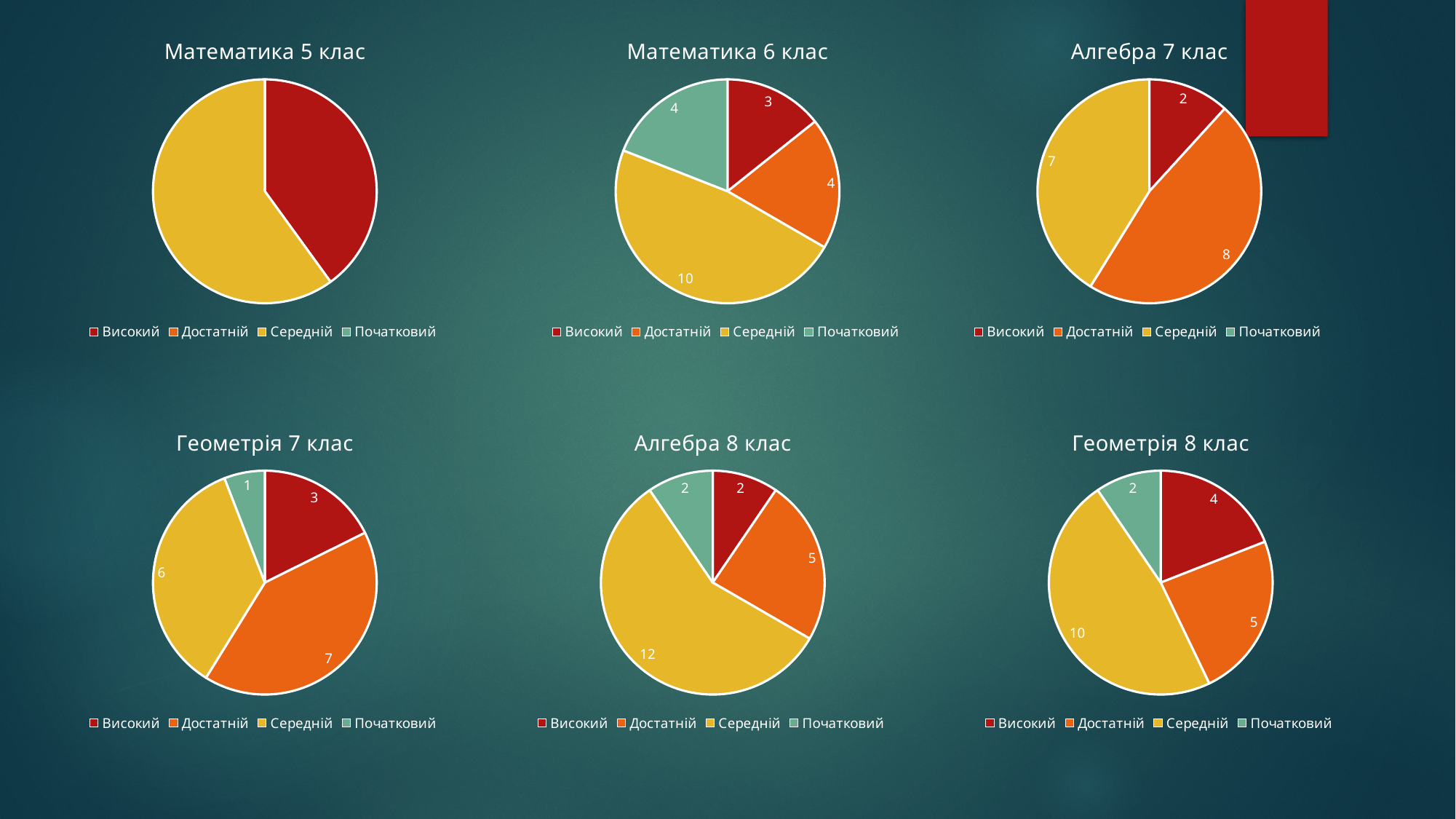
In the "Математика 6 клас" chart, what is the value for Середній? 10 In the "Геометрія 8 клас" chart, what is the difference between Середній and Достатній? 5 In the "Геометрія 7 клас" chart, what is the value for Високий? 3 In the "Геометрія 7 клас" chart, which category has the smallest slice? Початковий How many pie charts are shown on the slide? 6 In the "Геометрія 8 клас" chart, what is the value for Початковий? 2 How many categories does the legend of the "Алгебра 7 клас" chart list? 4 What kind of chart is used for "Математика 6 клас"? pie chart In the "Алгебра 7 клас" chart, what is the value for Достатній? 8 In the "Математика 5 клас" chart, which slice is larger, Високий or Середній? Середній In the "Алгебра 8 клас" chart, which category has the largest slice? Середній In the "Алгебра 8 клас" chart, what share of the total does Середній represent? 12 of 21